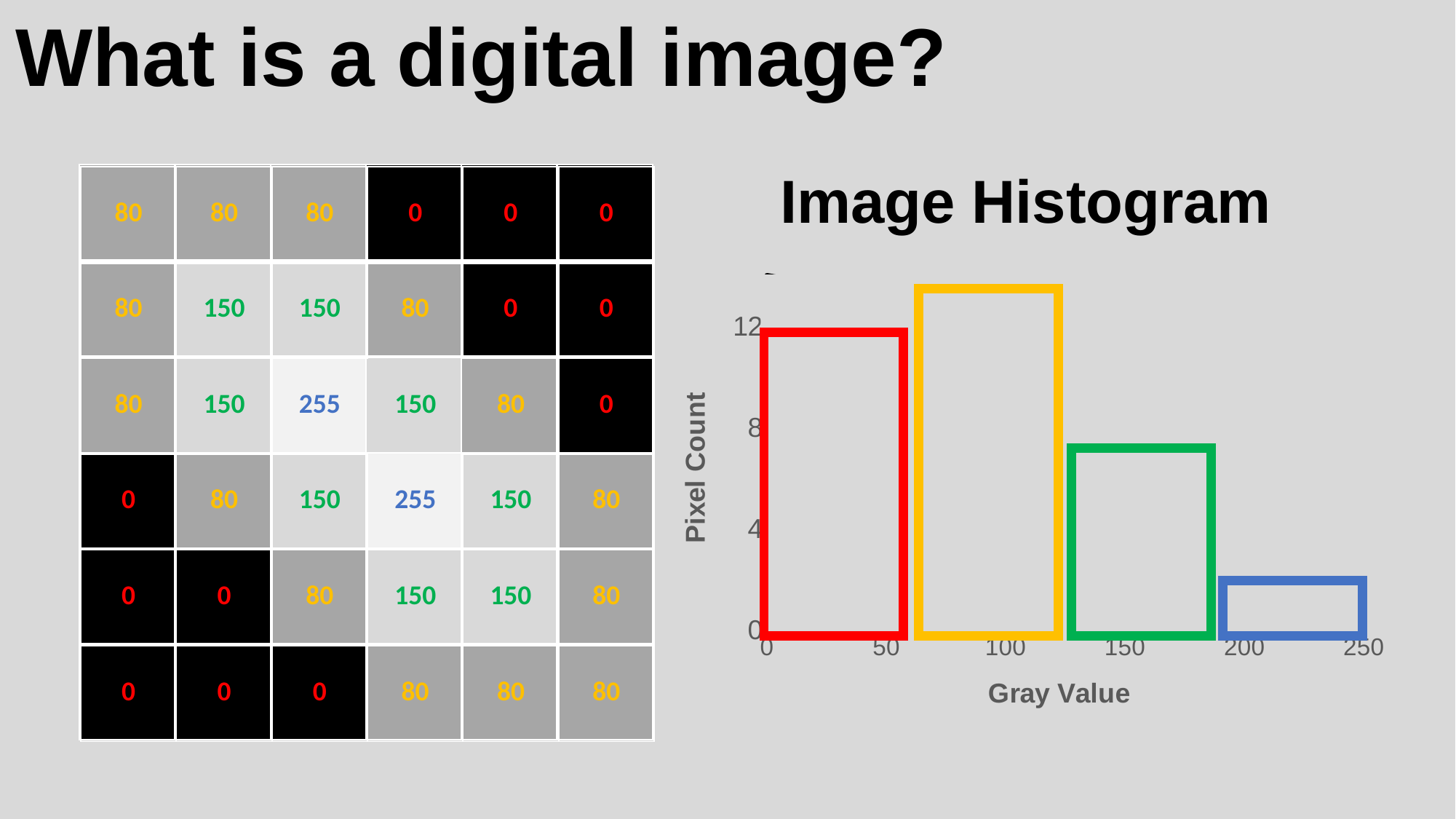
In the Image Histogram, do the bars rise or fall from the second bar to the fourth bar? fall How many bars are plotted in the Image Histogram? 4 In the Image Histogram, which bar is taller, the green bar or the blue bar? the green bar In the Image Histogram, which bar is taller, the red bar or the green bar? the red bar What kind of chart is the Image Histogram? bar chart In the Image Histogram, which bar is the tallest? the yellow bar (second from left) In the Image Histogram, is the pixel count for the red bar greater or less than 8? greater In the Image Histogram, which bar is the shortest? the blue bar (rightmost) In the Image Histogram, is the pixel count for the blue bar greater or less than 4? less In the Image Histogram, is the pixel count for the yellow bar greater or less than 12? greater What is the label of the x axis of the Image Histogram? Gray Value